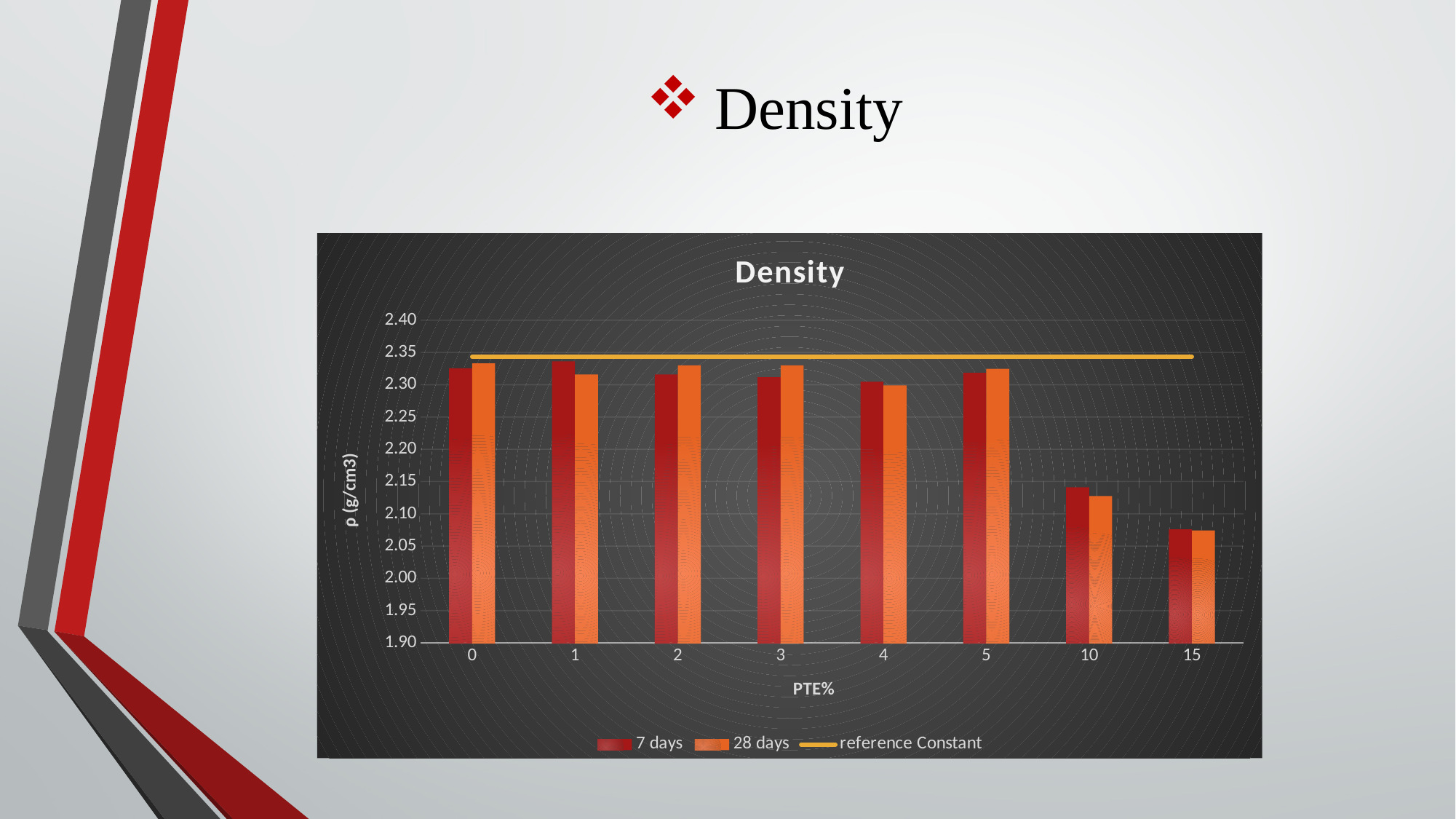
What is the label of the x axis of the chart? PTE% What kind of chart is shown on the slide? bar chart How many PTE% categories are shown on the x axis of the Density chart? 8 Is the 28 days value at PTE% 15 greater or less than 2.10? less How many entries does the legend of the Density chart list? 3 Is the 7 days value at PTE% 0 greater or less than 2.30? greater Which PTE% category has the lowest 28 days density? 15 Which PTE% category has the lowest 7 days density? 15 Which is larger, the 7 days value at PTE% 10 or the 7 days value at PTE% 15? PTE% 10 Is the 7 days value at PTE% 10 greater or less than 2.10? greater What is the title of the chart? Density Do the density values generally rise or fall as PTE% increases along the x axis? fall